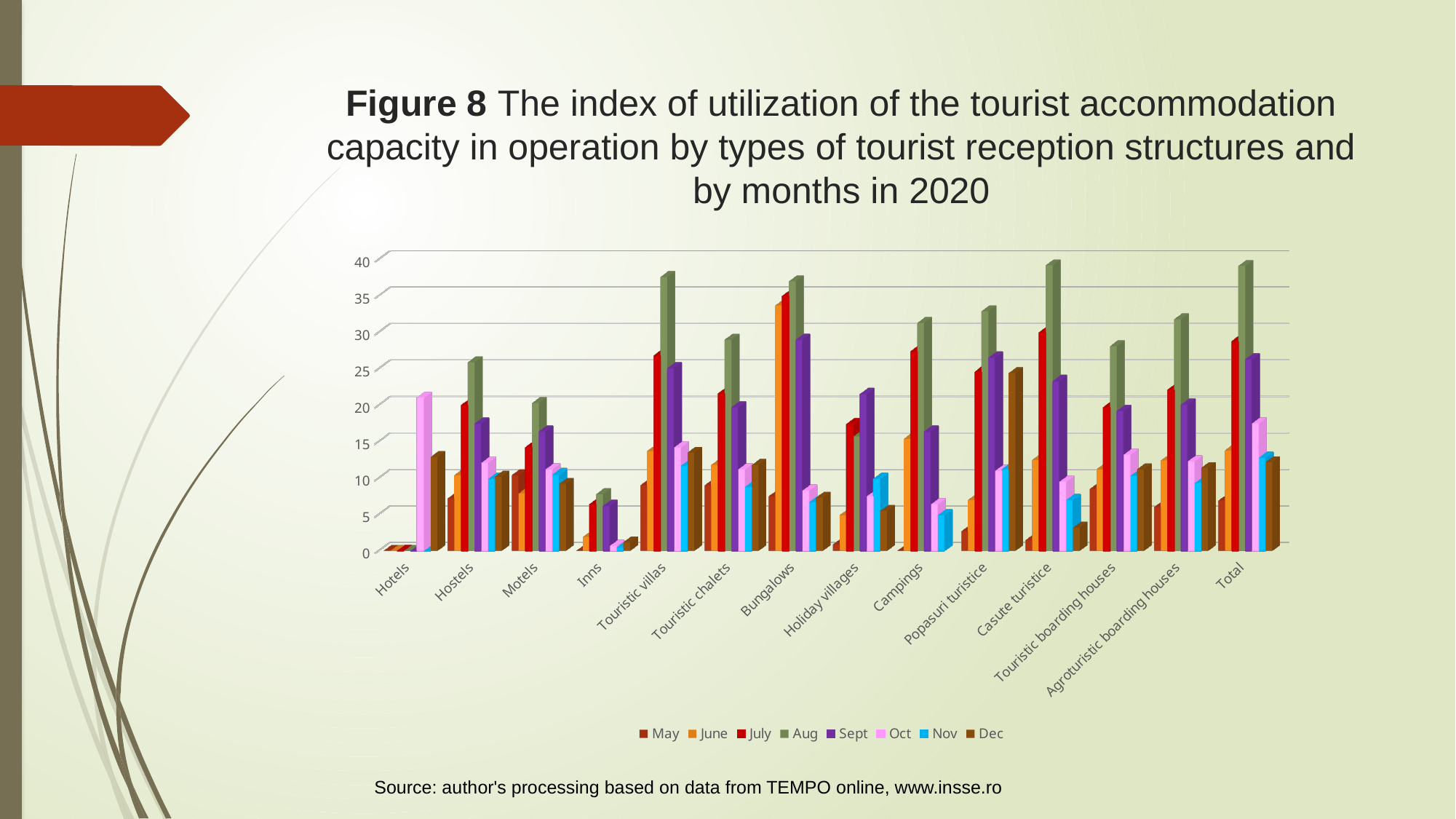
Is the Aug value for Total greater or less than 35? greater For Holiday villages, which is larger: the Sept value or the June value? Sept Is the Aug value for Touristic villas greater or less than 35? greater What kind of chart is shown on the slide? Bar chart Which month is listed first in the legend? May Is the Aug value for Inns greater or less than 10? less How many series (months) does the legend list? 8 For the Total category, which month has the highest index of utilization? Aug For Hotels, which month has the highest bar? Oct For Bungalows, which is larger: the Aug value or the Nov value? Aug How many types of tourist reception structures (categories) are shown on the x axis, including Total? 14